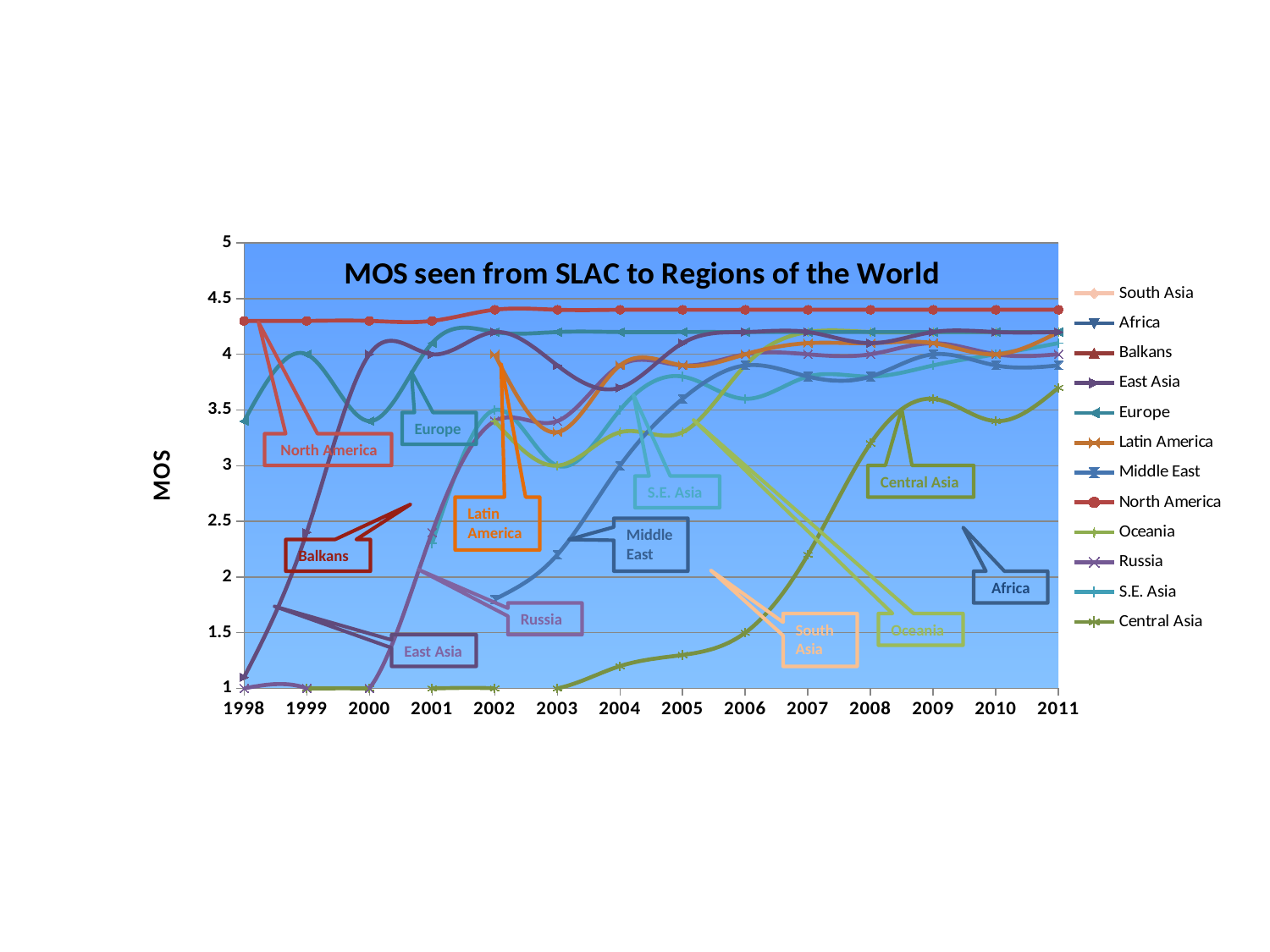
Is the value for Europe in 1998 greater or less than 4? less Is the value for Middle East in 2002 greater or less than 2? less What is the label on the y axis? MOS Which is larger in 1998, the value for North America or the value for Europe? North America Which region has the highest MOS in 2011? North America Which is larger in 2006, the value for North America or the value for South Asia? North America How many series does the legend list? 12 What is the title of the chart? MOS seen from SLAC to Regions of the World Does the Middle East line rise or fall from 2002 to 2011? rise How many years are shown along the x axis? 14 Is the value for North America in 2005 greater or less than 4? greater What kind of chart is shown on the slide? line chart